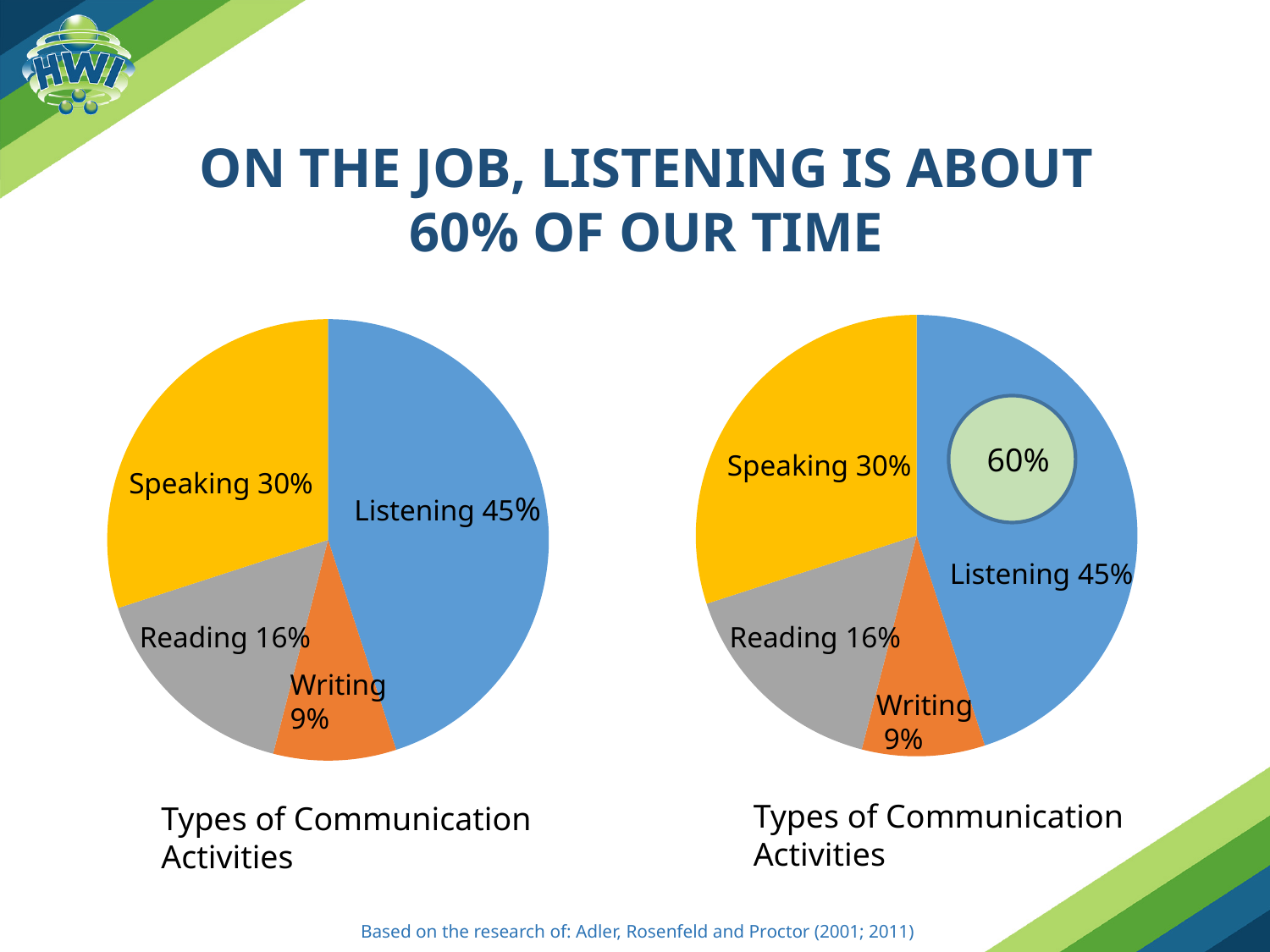
What is the title of the left chart? Types of Communication Activities In the left pie chart, which is larger, Speaking or Reading? Speaking In the right pie chart, what is the difference between Reading and Writing? 7% How many categories does the right pie chart show? 4 In the left pie chart, what is the value for Listening? 45% In the right pie chart, which category has the smallest slice? Writing In the left pie chart, what is the value for Writing? 9% In the left pie chart, which category has the largest slice? Listening In the right pie chart, what is the value for Reading? 16% What type of chart is shown on the left of the slide? Pie chart In the right pie chart, what is the value for Speaking? 30% In the left pie chart, what is the difference between Listening and Speaking? 15%